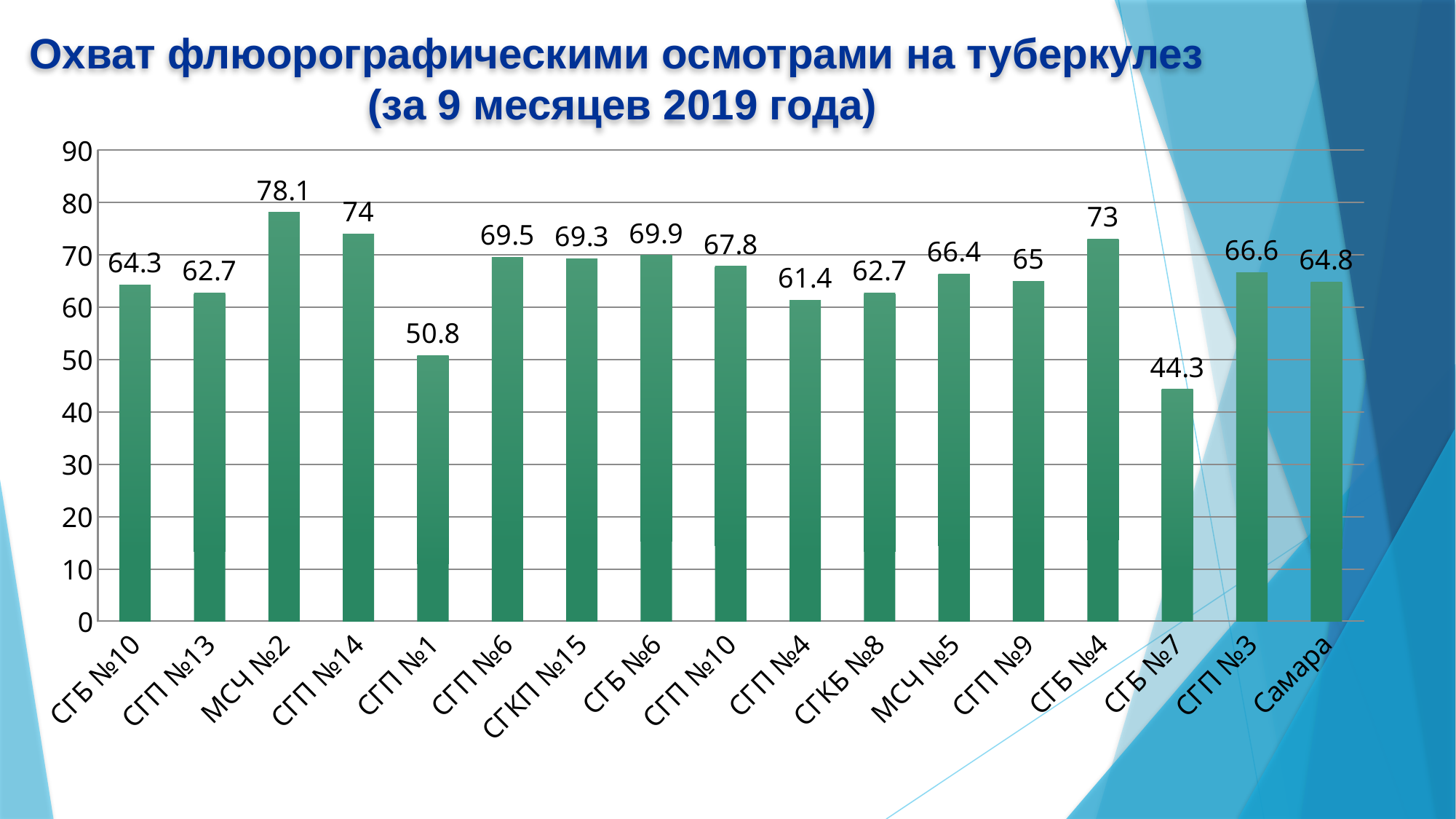
What is the value for СГБ №7? 44.3 What is the title of the chart? Охват флюорографическими осмотрами на туберкулез (за 9 месяцев 2019 года) What is the value for МСЧ №2? 78.1 What is the value for СГП №1? 50.8 What kind of chart is shown on the slide? bar chart Which category has the highest value? МСЧ №2 Which is larger, the value for СГП №14 or the value for СГБ №4? СГП №14 Which category has the lowest value? СГБ №7 What is the value for Самара? 64.8 Is the value for СГП №1 greater or less than 60? less What is the difference between the values for МСЧ №2 and СГБ №7? 33.8 How many categories are shown on the x axis? 17